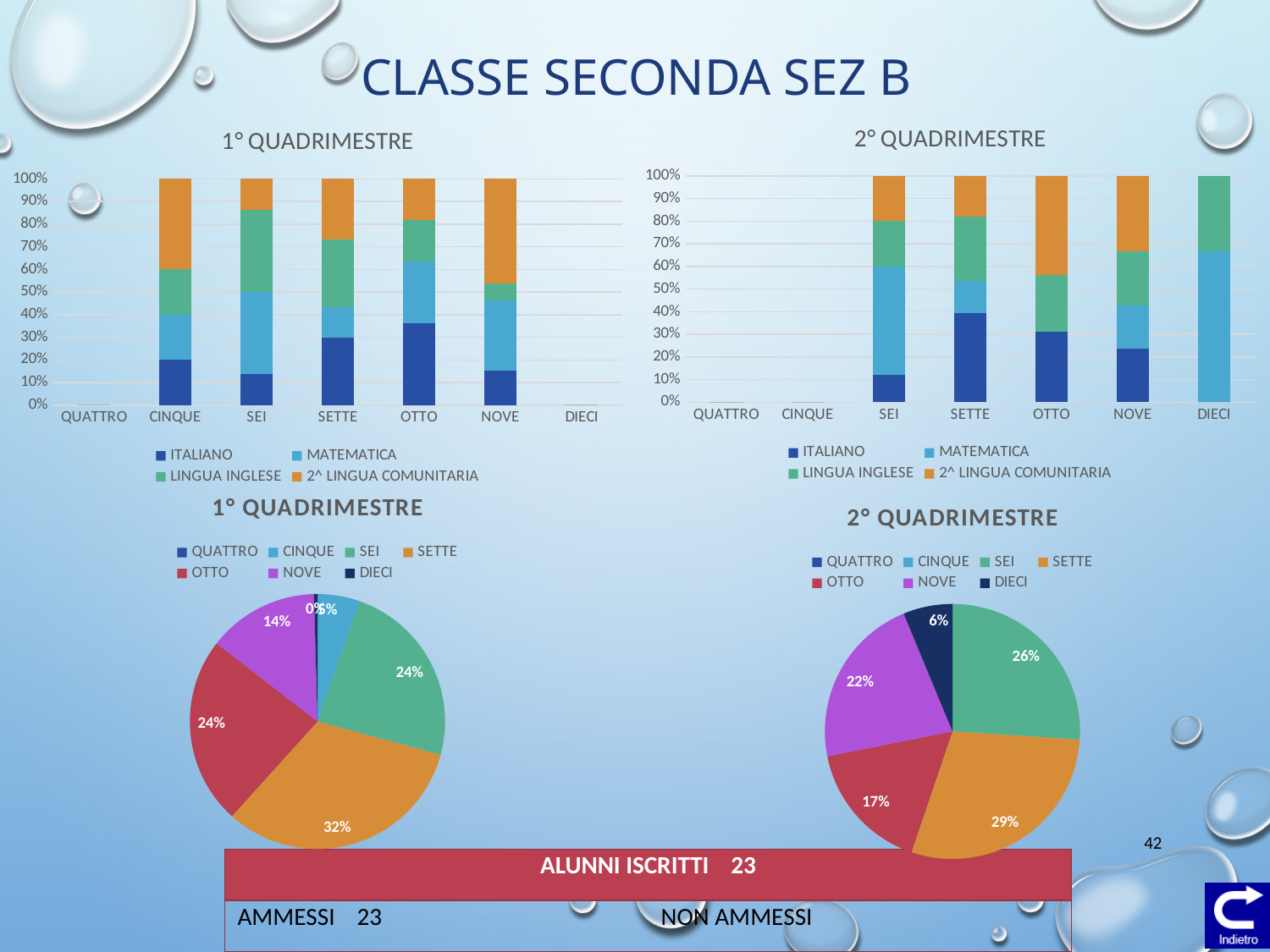
In the bottom-right pie chart (2° QUADRIMESTRE), which category has the largest slice? SETTE In the bottom-right pie chart (2° QUADRIMESTRE), what is the difference between the shares of SEI and OTTO? 9% In the bottom-left pie chart (1° QUADRIMESTRE), which category has the largest slice? SETTE How many series does the legend of the top-left bar chart (1° QUADRIMESTRE) list? 4 What kind of chart is the top-right chart (2° QUADRIMESTRE)? Stacked bar chart In the bottom-right pie chart (2° QUADRIMESTRE), which is larger, the share of NOVE or the share of OTTO? NOVE In the top-right bar chart (2° QUADRIMESTRE), is the ITALIANO value for SETTE greater or less than 30%? greater In the bottom-right pie chart (2° QUADRIMESTRE), what share does SETTE have? 29% In the bottom-left pie chart (1° QUADRIMESTRE), what share does SETTE have? 32% In the bottom-left pie chart (1° QUADRIMESTRE), what share does NOVE have? 14% How many categories are shown on the x axis of the top-left bar chart (1° QUADRIMESTRE)? 7